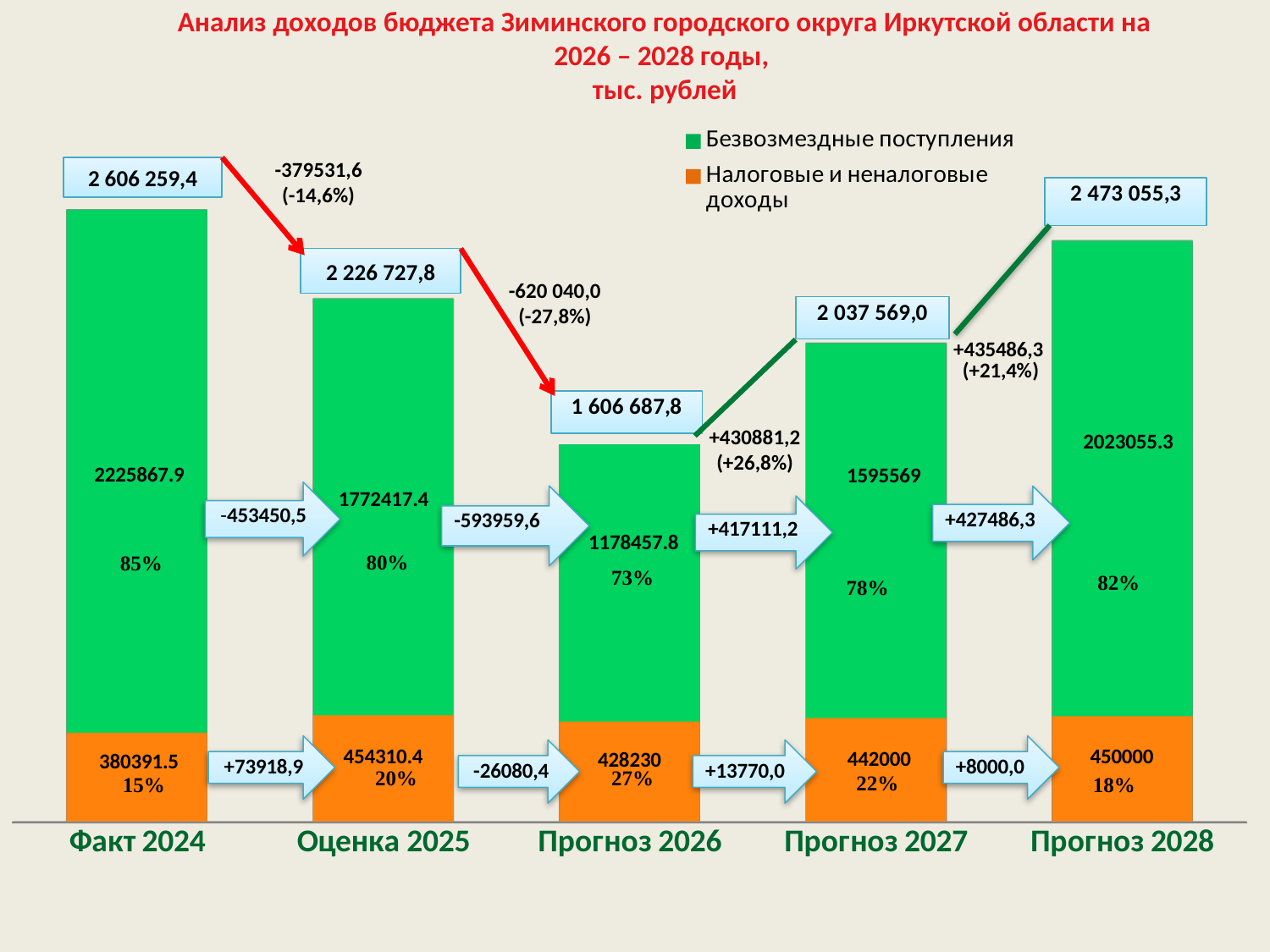
What share of total income do Безвозмездные поступления make up in Факт 2024? 85% Which category has the lowest value for Налоговые и неналоговые доходы? Факт 2024 What is the value of Налоговые и неналоговые доходы for Прогноз 2028? 450000 Which category has the lowest total income? Прогноз 2026 What is the value of Безвозмездные поступления for Факт 2024? 2225867.9 Which category has the highest total income? Факт 2024 How many series does the legend list? 2 What kind of chart is shown on the slide? Stacked bar chart What is the difference between Безвозмездные поступления for Факт 2024 and Оценка 2025? 453450.5 What is the total budget income shown for Прогноз 2026? 1 606 687,8 Which is larger: Безвозмездные поступления for Прогноз 2027 or for Прогноз 2026? Прогноз 2027 How many categories are shown on the x axis? 5